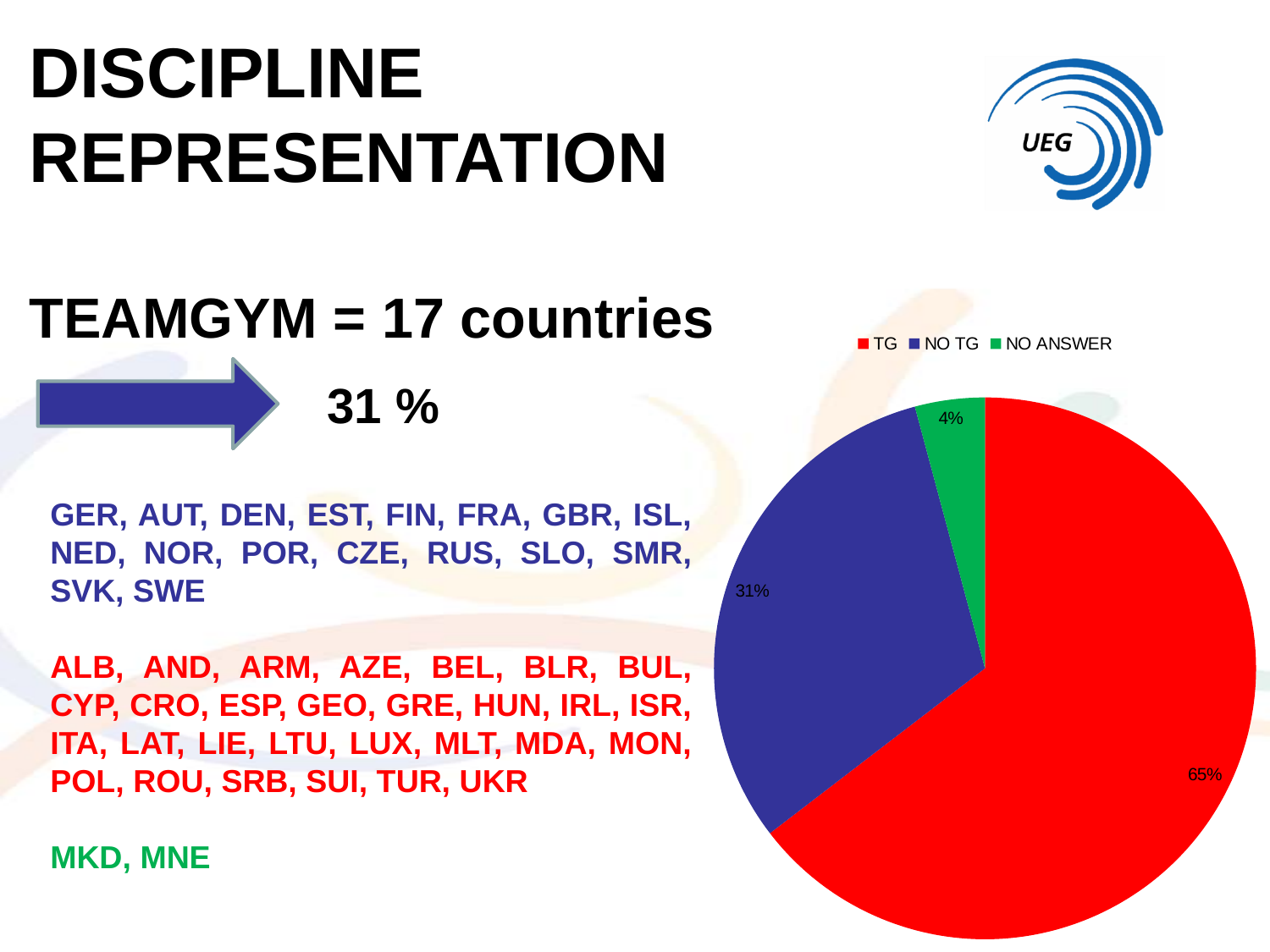
What type of chart is shown on the slide? pie chart Which is larger in the pie chart, the NO TG slice or the NO ANSWER slice? NO TG What colour is the NO ANSWER slice in the pie chart? green Which slice of the pie chart is the largest? TG According to the legend, what percentage is shown for the NO TG slice of the pie chart? 31% What percentage is shown for the NO ANSWER slice of the pie chart? 4% Which slice of the pie chart is the smallest? NO ANSWER How many entries does the pie chart's legend list? 3 How many slices does the pie chart have? 3 According to the legend, what percentage is shown for the TG slice of the pie chart? 65% What are the three entries listed in the pie chart's legend? TG, NO TG, NO ANSWER What is the difference in percentage points between the 65% slice and the 31% slice of the pie chart? 34